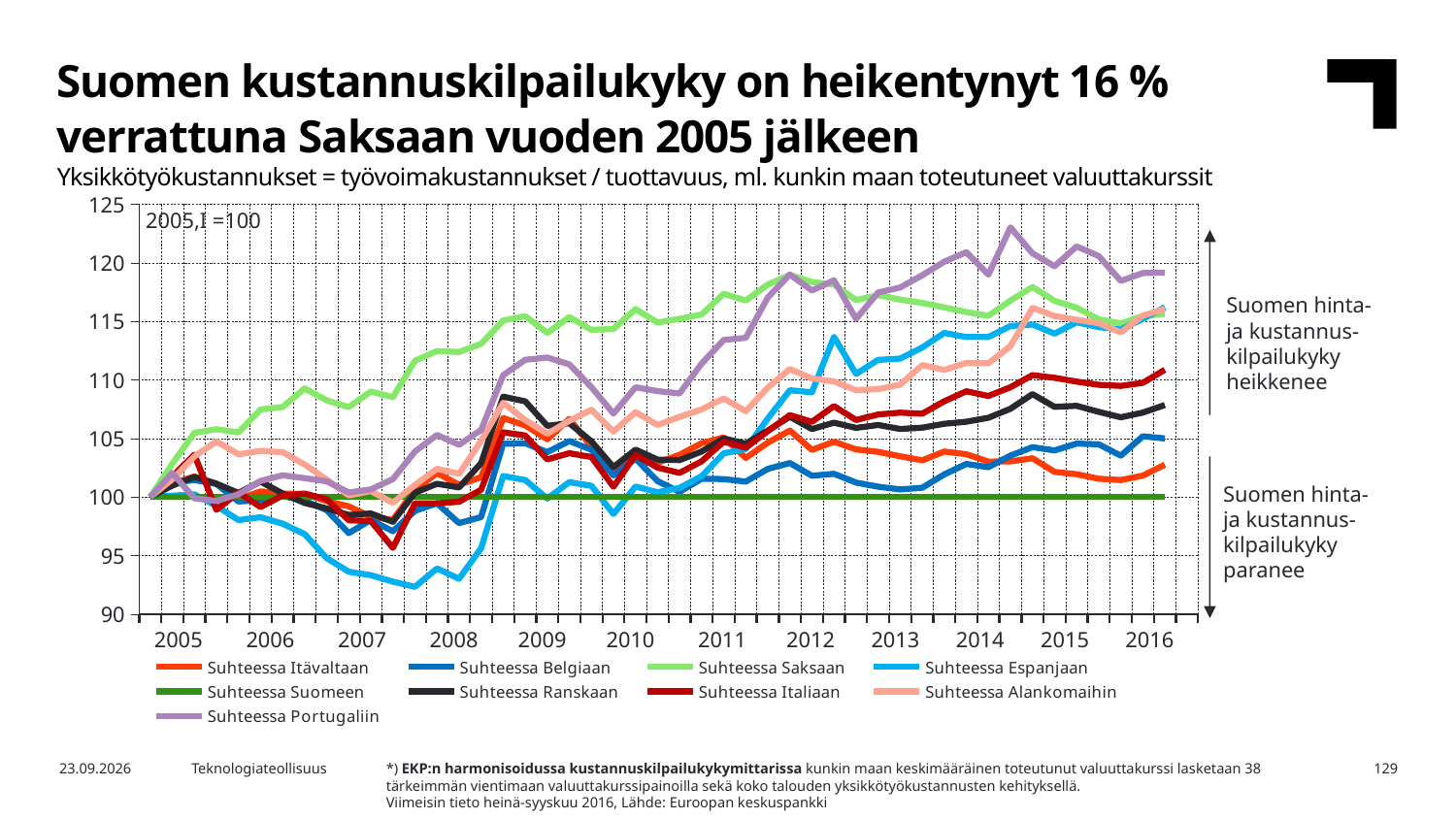
What kind of chart is shown on the slide? line chart Which series is highest at the end of the chart in 2016? Suhteessa Portugaliin How many series does the legend list? 9 Does the Suhteessa Saksaan series overall rise or fall from 2005 to 2016? rise What is the index base value stated in the chart (2005,I = ?) 100 Which series stays flat at 100 throughout the whole period? Suhteessa Suomeen Is the lowest value for Suhteessa Espanjaan in 2008 greater or less than 95? less How many year labels are shown on the x axis? 12 According to the slide title, by how much has Finland's cost competitiveness weakened compared to Germany since 2005? 16 % At the end of 2016, which is larger: Suhteessa Italiaan or Suhteessa Belgiaan? Suhteessa Italiaan What is the highest value shown on the y axis? 125 Is the value for Suhteessa Portugaliin at the end of 2016 greater or less than 115? greater